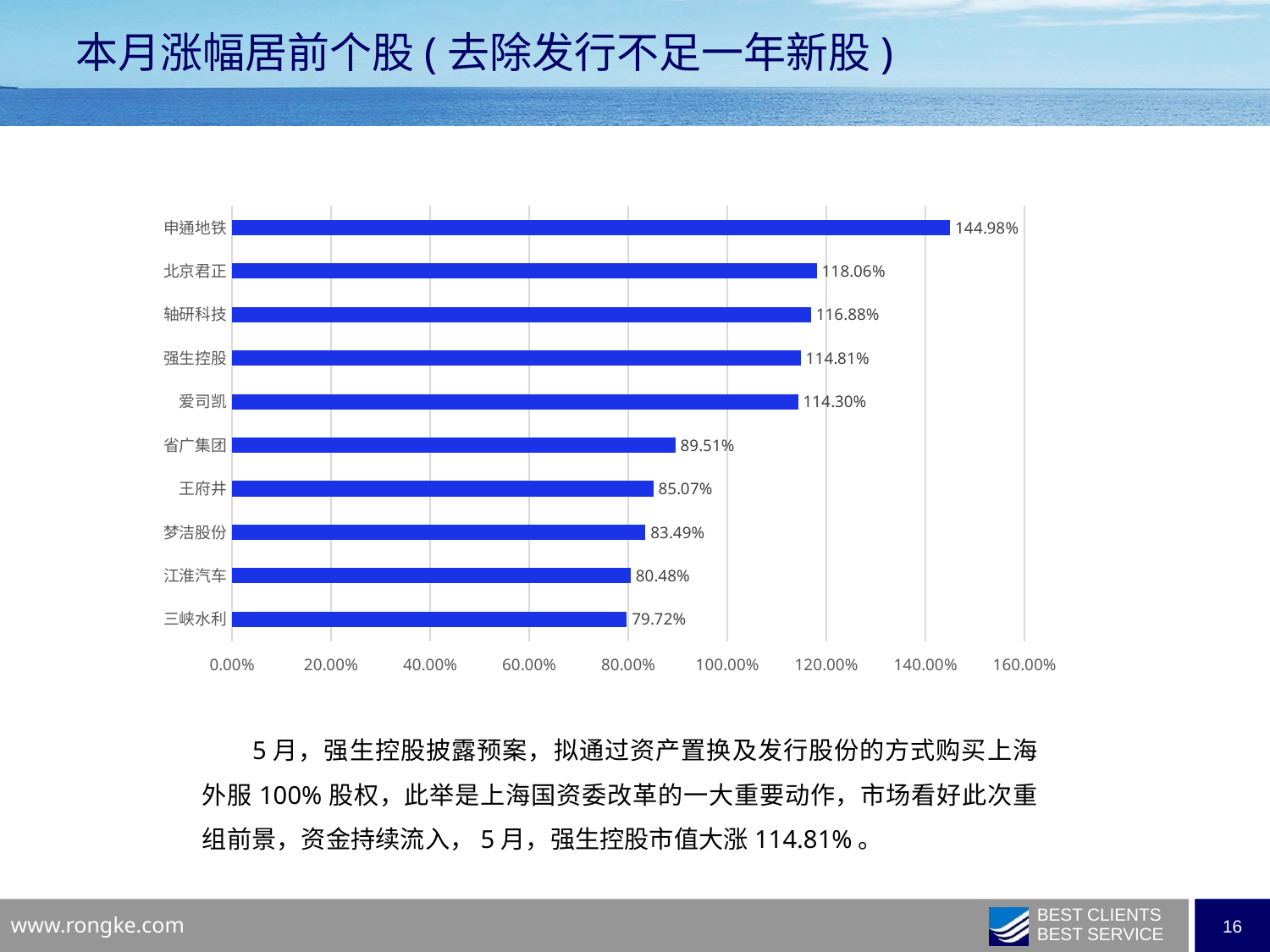
Which is larger, the value for 爱司凯 or the value for 省广集团? 爱司凯 Which stock has the highest value? 申通地铁 What is the value for 申通地铁? 144.98% What is the value for 三峡水利? 79.72% Which stock has the lowest value? 三峡水利 What is the difference between the values for 申通地铁 and 北京君正? 26.92% What is the maximum value shown on the horizontal axis? 160.00% Is the value for 梦洁股份 greater or less than 100.00%? less What is the difference between the values for 省广集团 and 王府井? 4.44% How many stocks are shown in the chart? 10 What is the value for 强生控股? 114.81% What kind of chart is shown on the slide? bar chart